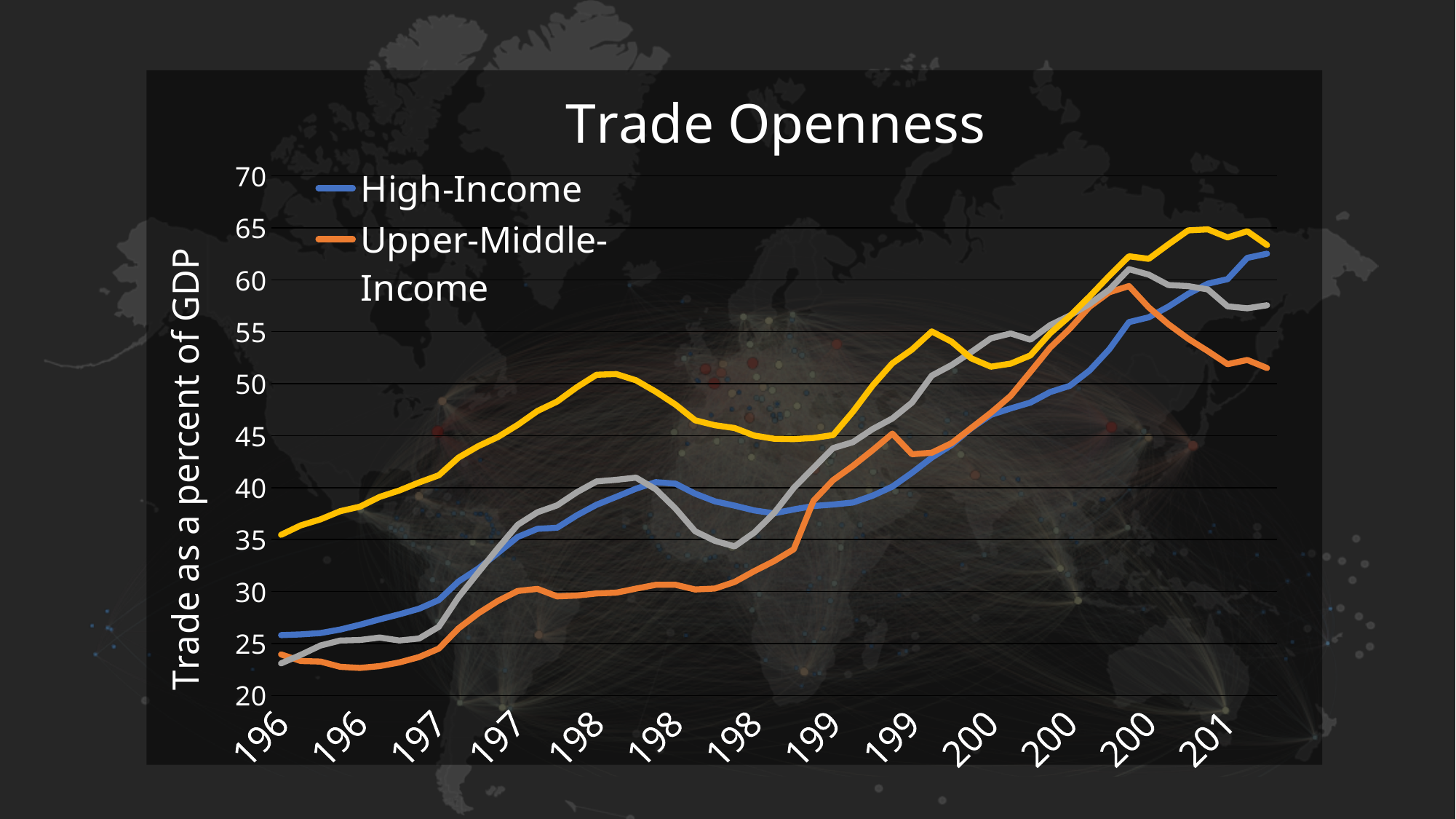
Does the Upper-Middle-Income line rise or fall overall from the left of the chart to the right? rise What is the label on the vertical axis of the chart? Trade as a percent of GDP Does the High-Income line rise or fall overall from the left of the chart to the right? rise Is the value for High-Income at the right end of the chart greater or less than 60? greater Is the value for Upper-Middle-Income at the left end of the chart greater or less than 25? less What is the title of the chart? Trade Openness Is the value for Upper-Middle-Income at the right end of the chart greater or less than 55? less What kind of chart is shown on the slide? line chart At the right end of the chart, which is higher: High-Income or Upper-Middle-Income? High-Income How many series does the chart's legend list? 2